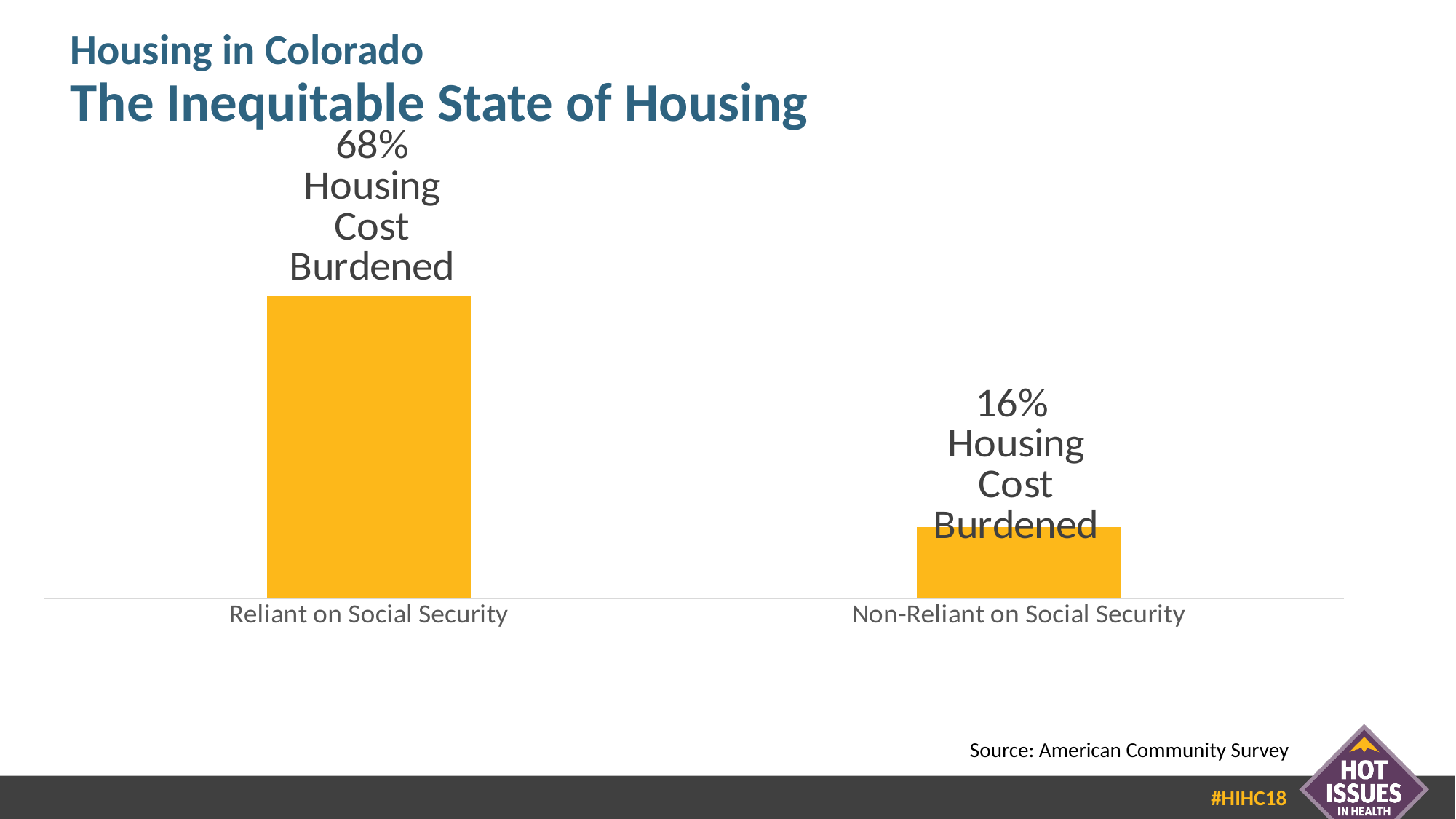
What colour are the bars in the chart? Yellow What is the source cited for the chart data? American Community Survey Is the housing cost burdened share larger for those reliant on Social Security or those non-reliant on Social Security? Reliant on Social Security Which category has the lower share of housing cost burdened households? Non-Reliant on Social Security What percentage of households non-reliant on Social Security are housing cost burdened? 16% Which category has the higher share of housing cost burdened households? Reliant on Social Security What percentage of households reliant on Social Security are housing cost burdened? 68% What is the difference in percentage points between the housing cost burdened share for those reliant on Social Security and those non-reliant? 52 percentage points What kind of chart is shown on the slide? Bar chart How many categories are shown in the chart? 2